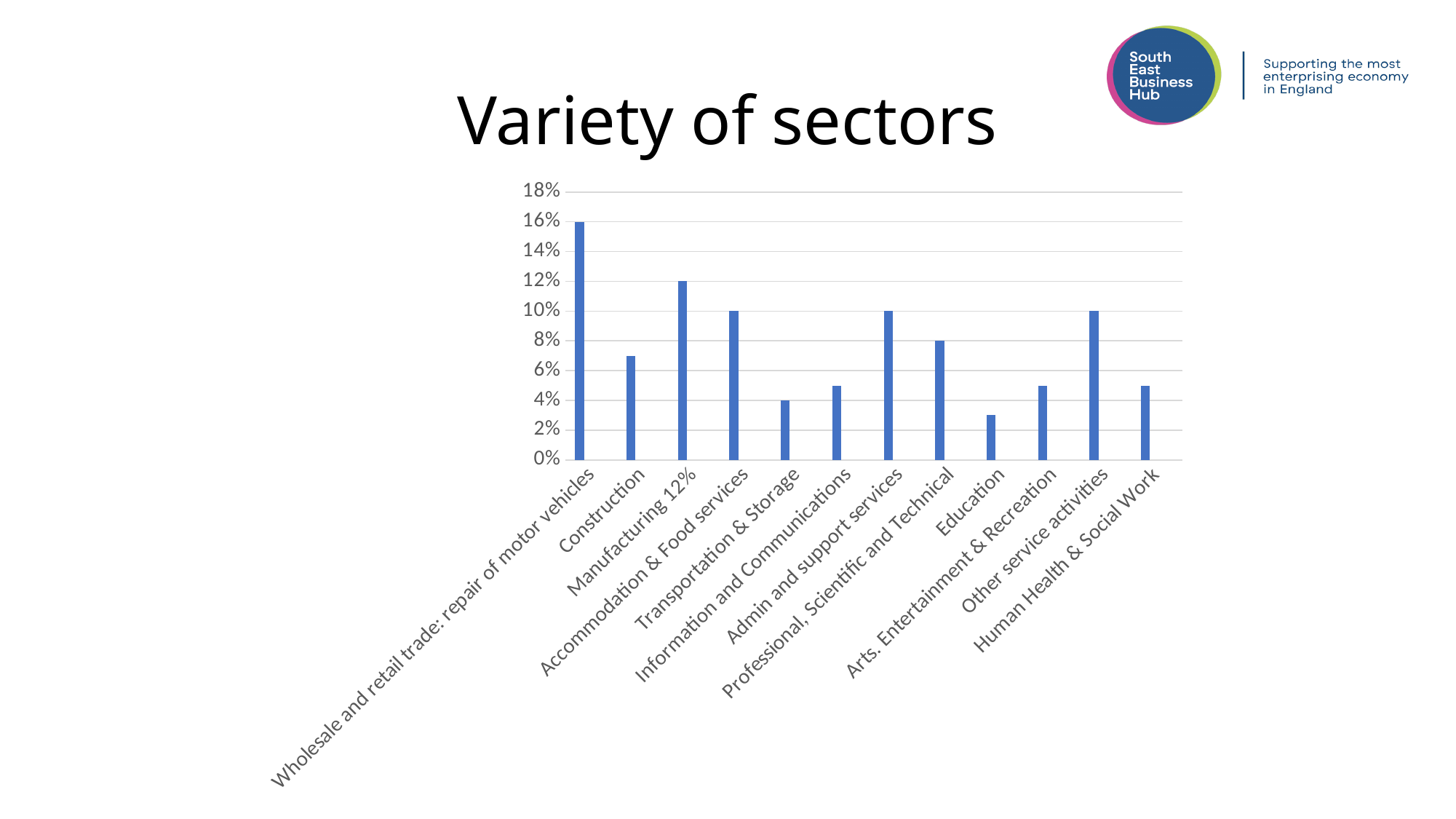
What is the difference between the values for Wholesale and retail trade: repair of motor vehicles and Manufacturing? 4% Is the value for Education greater or less than 4%? less Is the value for Construction greater or less than 6%? greater How many sectors are plotted in the chart? 12 What is the value for Wholesale and retail trade: repair of motor vehicles? 16% Which is larger, the value for Manufacturing or the value for Professional, Scientific and Technical? Manufacturing Which sector has the lowest value in the chart? Education Which sector has the highest value in the chart? Wholesale and retail trade: repair of motor vehicles What kind of chart is shown on the slide? bar chart What is the value for Transportation & Storage? 4% What is the value for Professional, Scientific and Technical? 8% What is the value for Manufacturing? 12%